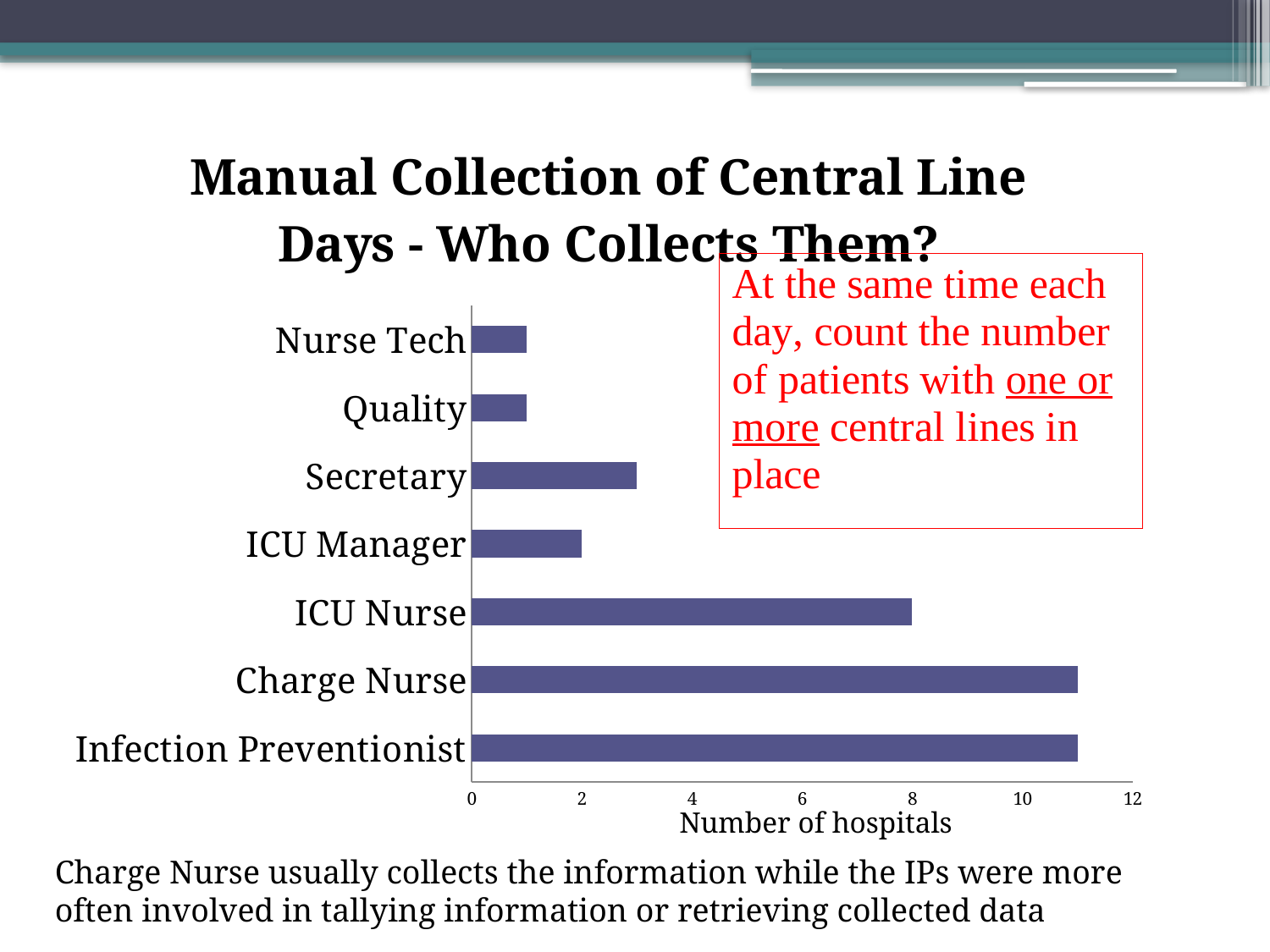
Is the value for Infection Preventionist greater or less than 10? greater What is the title of the chart? Manual Collection of Central Line Days - Who Collects Them? What is the label of the horizontal axis of the chart? Number of hospitals Which has a larger value, Charge Nurse or ICU Manager? Charge Nurse Which has a larger value, ICU Nurse or Secretary? ICU Nurse Is the value for Secretary greater or less than 4? less What is the number of hospitals for ICU Nurse? 8 What kind of chart is shown on the slide? Bar chart Is the value for Nurse Tech greater or less than 2? less How many categories (roles) are shown on the chart? 7 What is the number of hospitals for ICU Manager? 2